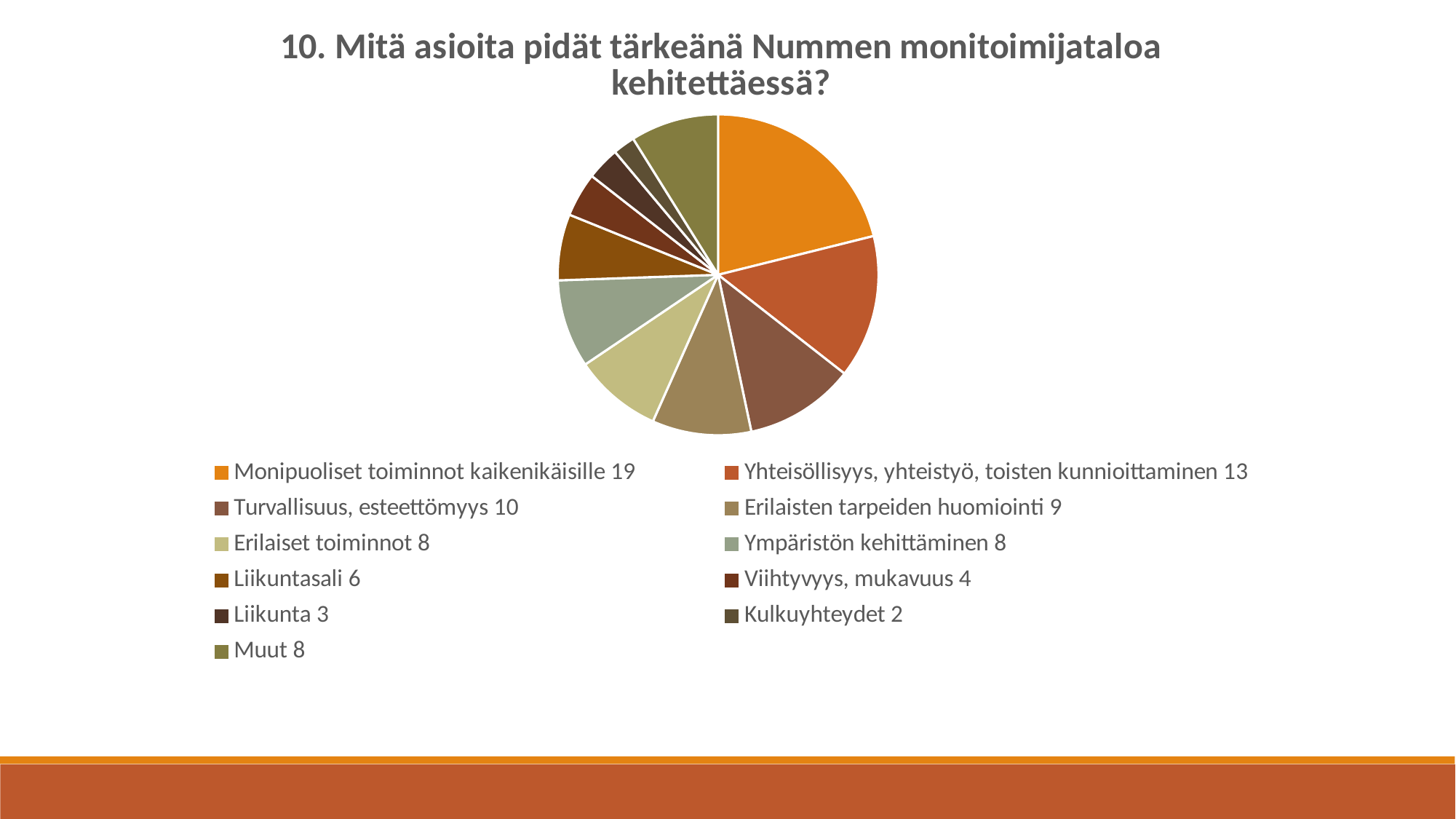
What is the title of the chart? 10. Mitä asioita pidät tärkeänä Nummen monitoimijataloa kehitettäessä? Which is larger, the value for Turvallisuus, esteettömyys or the value for Erilaisten tarpeiden huomiointi? Turvallisuus, esteettömyys What is the value for Liikuntasali? 6 What is the difference between the values for Liikuntasali and Liikunta? 3 What is the value for Kulkuyhteydet? 2 Which category has the largest slice of the pie? Monipuoliset toiminnot kaikenikäisille How many categories does the pie chart have? 11 What kind of chart is shown on the slide? Pie chart What is the value for Monipuoliset toiminnot kaikenikäisille? 19 Which category has the smallest slice of the pie? Kulkuyhteydet What is the value for Yhteisöllisyys, yhteistyö, toisten kunnioittaminen? 13 What is the difference between the values for Monipuoliset toiminnot kaikenikäisille and Yhteisöllisyys, yhteistyö, toisten kunnioittaminen? 6